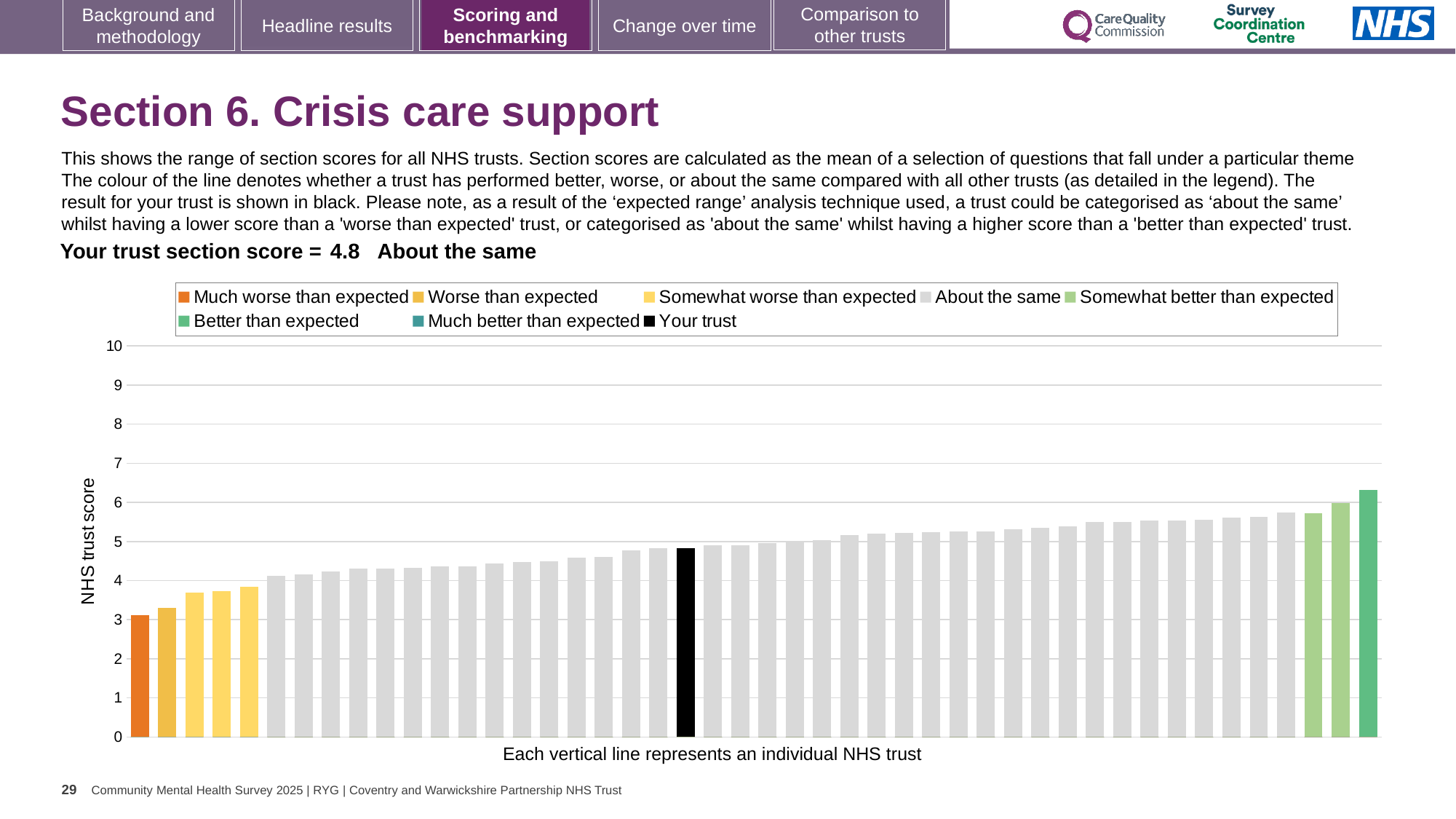
Which legend category does the lowest bar in the chart belong to? Much worse than expected Is the value of the 'Much worse than expected' bar greater or less than 4? less How many entries does the chart legend list? 8 Is the value of the 'Better than expected' bar greater or less than 6? greater How many bars are coloured as 'Somewhat worse than expected'? 3 Is the value of the 'Your trust' bar greater or less than 5? less Which category does your trust fall into according to the slide? About the same What kind of chart is shown on the slide? bar chart What is the label on the vertical axis of the chart? NHS trust score Which legend category does the highest bar in the chart belong to? Better than expected What is the section score for your trust shown on the slide? 4.8 Do the bar values rise or fall from left to right across the chart? rise